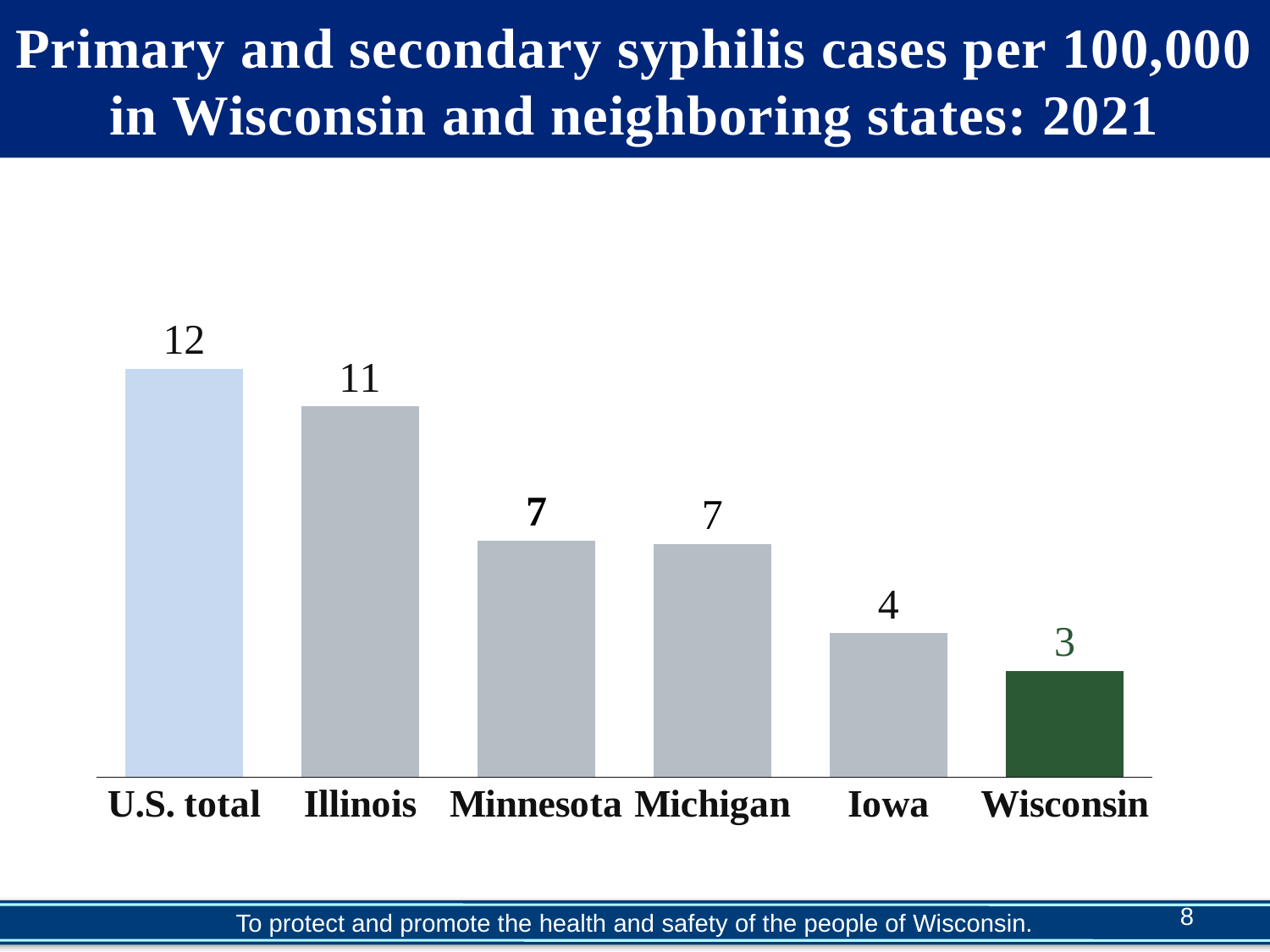
What is the title of the chart? Primary and secondary syphilis cases per 100,000 in Wisconsin and neighboring states: 2021 What is the value for U.S. total? 12 What is the difference between the values for U.S. total and Wisconsin? 9 How many categories are shown in the chart? 6 What is the difference between the values for Illinois and Iowa? 7 What is the value for Iowa? 4 Which category has the highest value? U.S. total Which is larger, the value for Illinois or the value for Minnesota? Illinois What is the value for Illinois? 11 Which category has the lowest value? Wisconsin What kind of chart is shown on the slide? bar chart What is the value for Wisconsin? 3